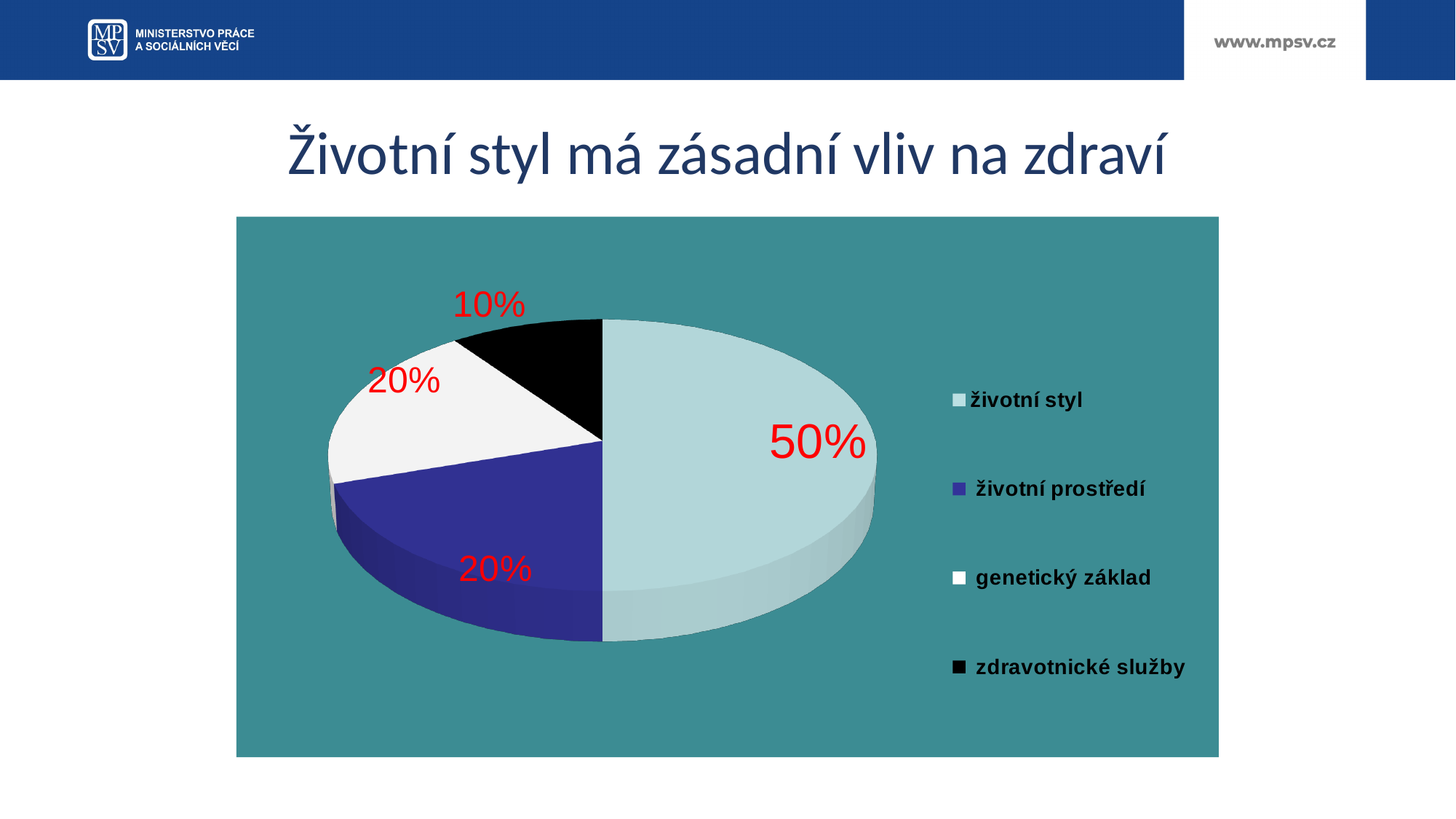
What is the difference in percentage points between životní styl and zdravotnické služby? 40 How many categories does the pie chart show? 4 Which category has the largest slice of the pie? životní styl What colour is the slice for zdravotnické služby? black Which category has the smallest slice of the pie? zdravotnické služby What share of the pie does genetický základ have? 20% What share of the pie does zdravotnické služby have? 10% Which is larger, the slice for životní styl or the slice for genetický základ? životní styl What is the title of the slide above the chart? Životní styl má zásadní vliv na zdraví What share of the pie does životní prostředí have? 20% What share of the pie does životní styl have? 50% What kind of chart is shown on the slide? pie chart